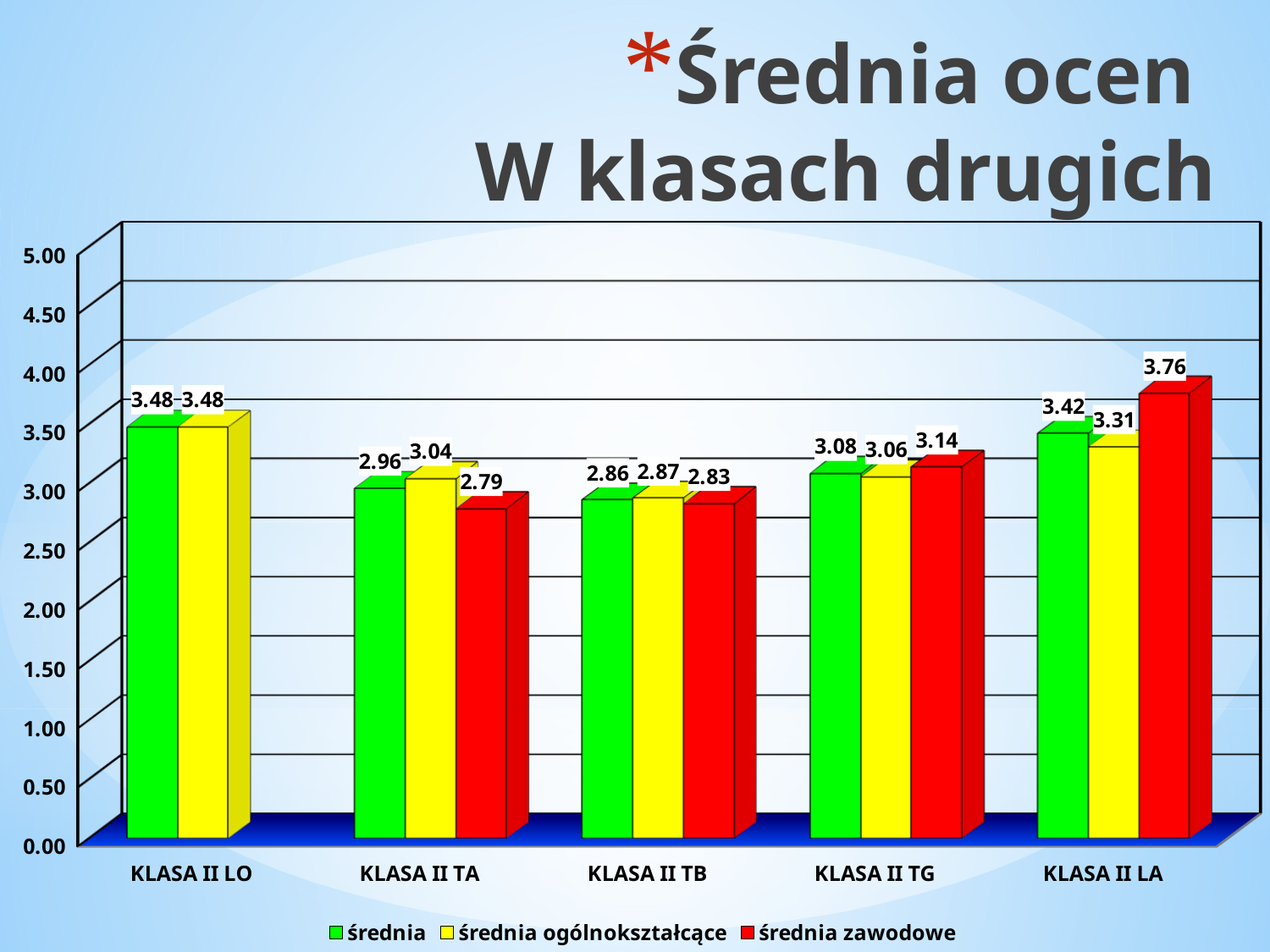
What is the 'średnia ogólnokształcące' value for KLASA II TG? 3.06 Which class has the highest 'średnia zawodowe' value? KLASA II LA Which class has the lowest 'średnia' value? KLASA II TB What is the 'średnia zawodowe' value for KLASA II LA? 3.76 How many classes are shown on the x axis? 5 How many series does the legend list? 3 Which is larger: the 'średnia' value for KLASA II LO or for KLASA II LA? KLASA II LO Which colour represents 'średnia zawodowe' in the legend? red Is the 'średnia zawodowe' value for KLASA II TB greater or less than 3.00? less What kind of chart is shown on the slide? bar chart What is the 'średnia' value for KLASA II TA? 2.96 What is the difference between the 'średnia zawodowe' values for KLASA II LA and KLASA II TA? 0.97